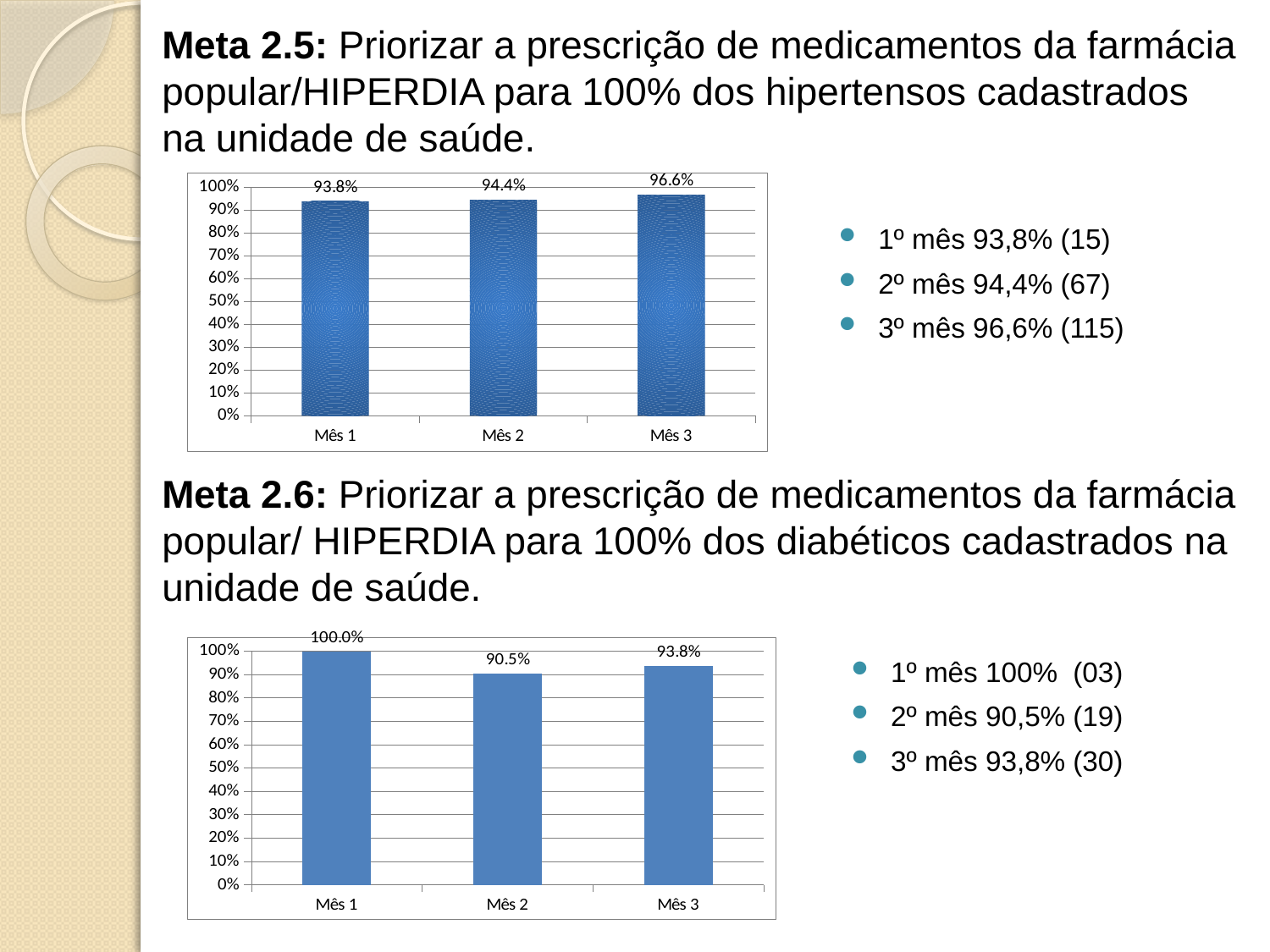
In the bottom chart (Meta 2.6), which month has the lowest value? Mês 2 In the bottom chart (Meta 2.6), which is larger, the value for Mês 2 or Mês 3? Mês 3 In the top chart (Meta 2.5), do the values rise or fall from Mês 1 to Mês 3? rise In the top chart (Meta 2.5), what is the value for Mês 2? 94.4% What kind of chart is the bottom chart (Meta 2.6)? bar chart In the bottom chart (Meta 2.6), what is the value for Mês 1? 100.0% In the top chart (Meta 2.5), which month has the highest value? Mês 3 In the bottom chart (Meta 2.6), what is the value for Mês 2? 90.5% In the top chart (Meta 2.5), how many bars are plotted? 3 In the top chart (Meta 2.5), what is the difference between the values for Mês 3 and Mês 1? 2.8% In the bottom chart (Meta 2.6), what is the difference between the values for Mês 1 and Mês 2? 9.5% In the top chart (Meta 2.5), which month has the lowest value? Mês 1